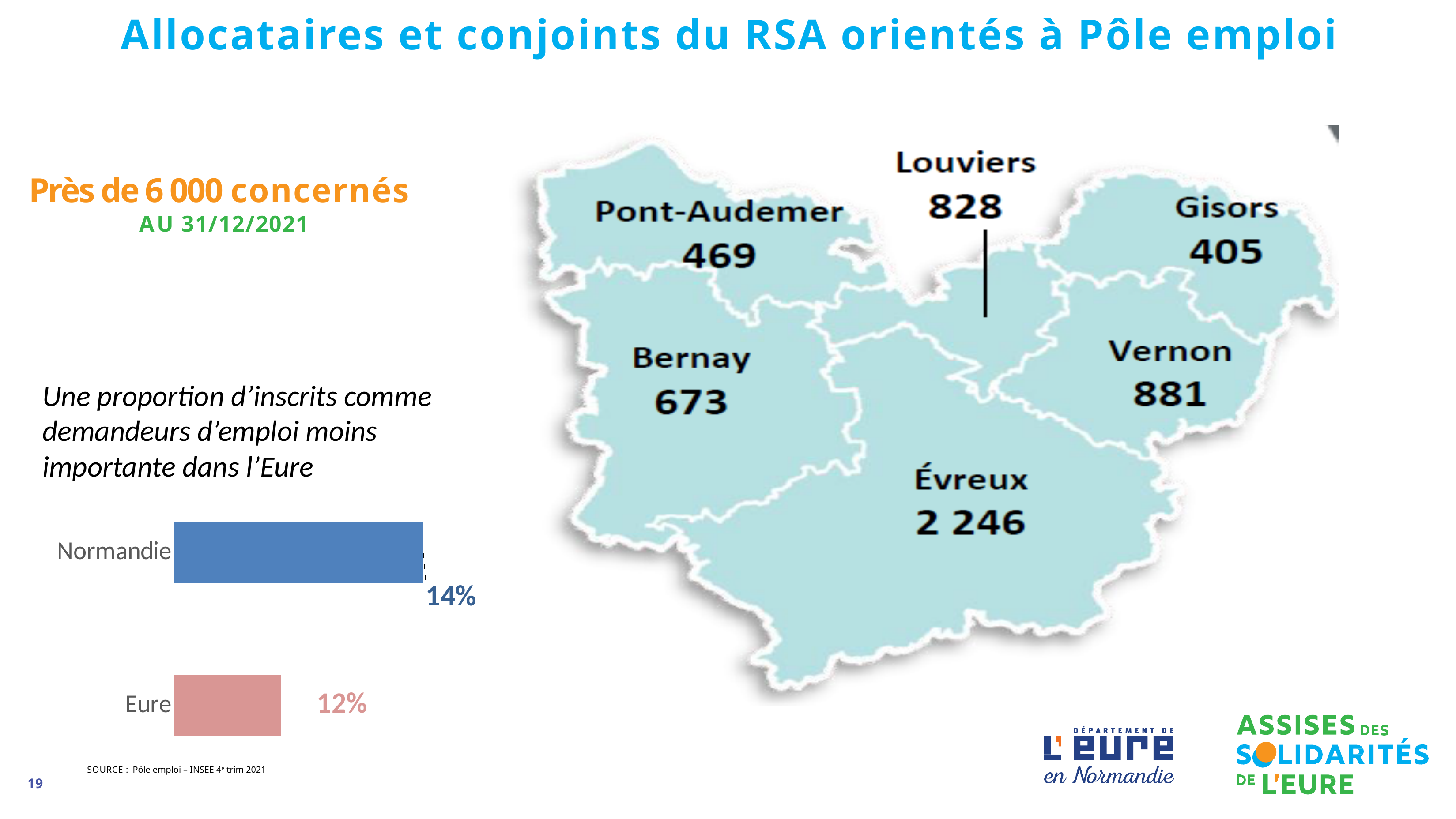
How many categories does the bar chart at the bottom left show? 2 In the bar chart at the bottom left, which category has the lower value? Eure In the bar chart at the bottom left, what colour is the Eure bar? pink On the map on the right, what is the value shown for Vernon? 881 In the bar chart at the bottom left, what is the value for Eure? 12% On the map on the right, which area has the lowest value? Gisors In the bar chart at the bottom left, what is the difference between the Normandie and Eure values? 2% What kind of chart is shown at the bottom left of the slide? bar chart In the bar chart at the bottom left, which category has the higher value? Normandie On the map on the right, what is the value shown for Évreux? 2 246 In the bar chart at the bottom left, is the value for Eure larger or smaller than the value for Normandie? smaller In the bar chart at the bottom left, what is the value for Normandie? 14%